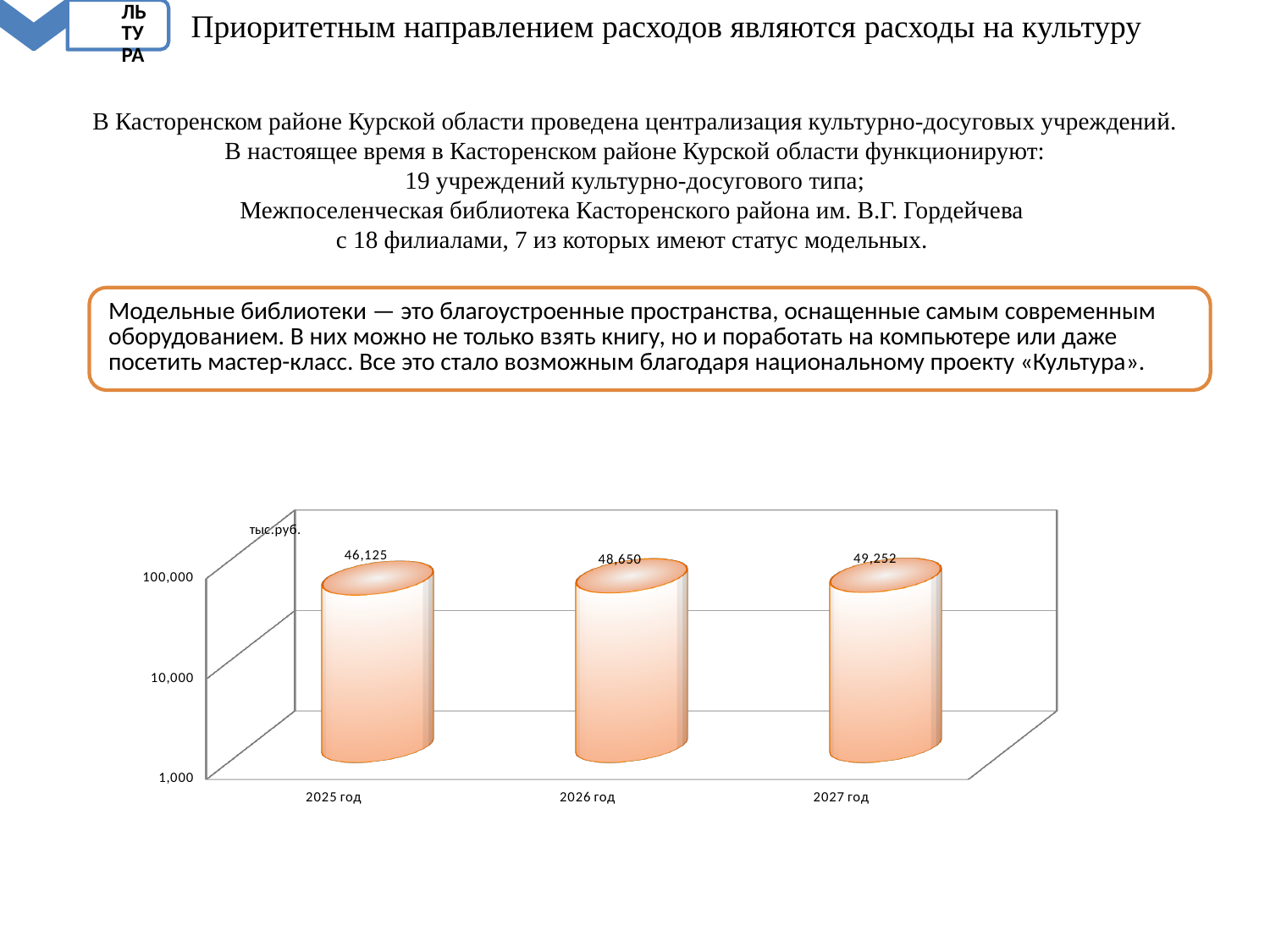
What value is shown for 2027 год? 49,252 Do the values rise or fall from 2025 год to 2027 год? rise What is the difference between the values for 2026 год and 2025 год? 2,525 What is the difference between the values for 2027 год and 2025 год? 3,127 Which year has the lowest value? 2025 год What value is shown for 2025 год? 46,125 What value is shown for 2026 год? 48,650 Is the value for 2025 год greater or less than 10,000? greater Which year has the highest value? 2027 год Which is larger, the value for 2026 год or the value for 2025 год? 2026 год What kind of chart is shown on the slide? bar chart How many years are shown on the chart? 3